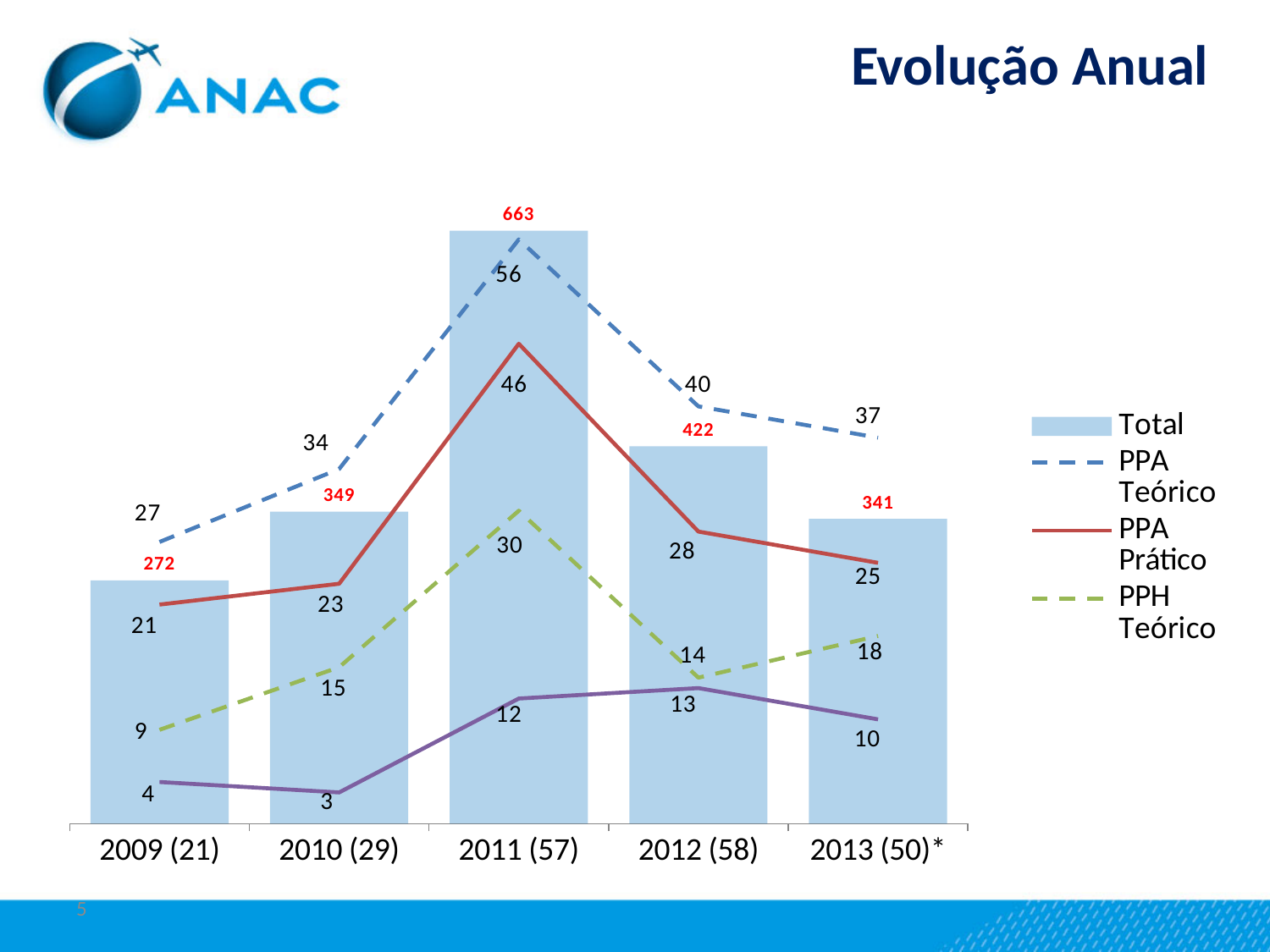
What is the difference between the Total for 2011 (57) and the Total for 2012 (58)? 241 How does the PPA Prático value change from 2011 (57) to 2013 (50)*? It falls What is the PPA Prático value for 2012 (58)? 28 Which year has the highest Total? 2011 (57) How many series does the legend list? 4 What is the Total value for 2011 (57)? 663 What is the PPH Teórico value for 2013 (50)*? 18 How many years are shown on the x axis? 5 What is the title of the slide containing the chart? Evolução Anual Which is larger, the PPA Teórico value for 2012 (58) or for 2013 (50)*? 2012 (58) Which year has the lowest PPH Teórico value? 2009 (21) What is the PPA Teórico value for 2010 (29)? 34